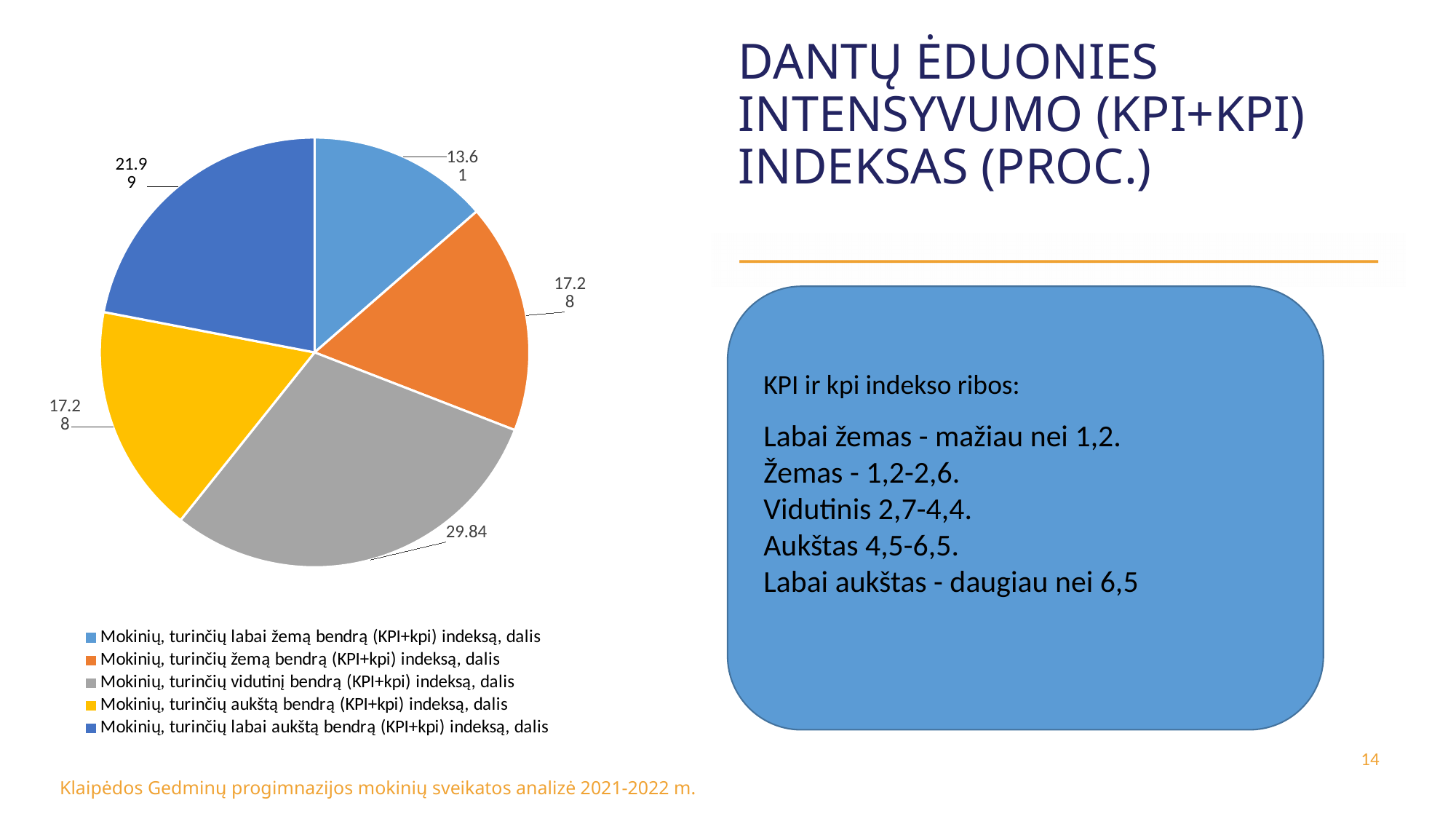
What is the difference between the value for 'vidutinį' (29.84) and the value for 'labai aukštą' (21.99) in the pie chart? 7.85 What is the value for 'Mokinių, turinčių vidutinį bendrą (KPI+kpi) indeksą, dalis' in the pie chart? 29.84 What type of chart is shown on the slide? Pie chart Which is larger in the pie chart: the value for 'labai aukštą' or the value for 'žemą'? Labai aukštą (21.99) Which category has the largest slice in the pie chart? Mokinių, turinčių vidutinį bendrą (KPI+kpi) indeksą, dalis What colour is used for 'Mokinių, turinčių vidutinį bendrą (KPI+kpi) indeksą, dalis' in the pie chart? Gray What is the value for 'Mokinių, turinčių labai aukštą bendrą (KPI+kpi) indeksą, dalis' in the pie chart? 21.99 What is the value for 'Mokinių, turinčių žemą bendrą (KPI+kpi) indeksą, dalis' in the pie chart? 17.28 What is the value for 'Mokinių, turinčių labai žemą bendrą (KPI+kpi) indeksą, dalis' in the pie chart? 13.61 How many slices does the pie chart have? 5 Which category has the smallest slice in the pie chart? Mokinių, turinčių labai žemą bendrą (KPI+kpi) indeksą, dalis How many entries does the legend of the pie chart list? 5